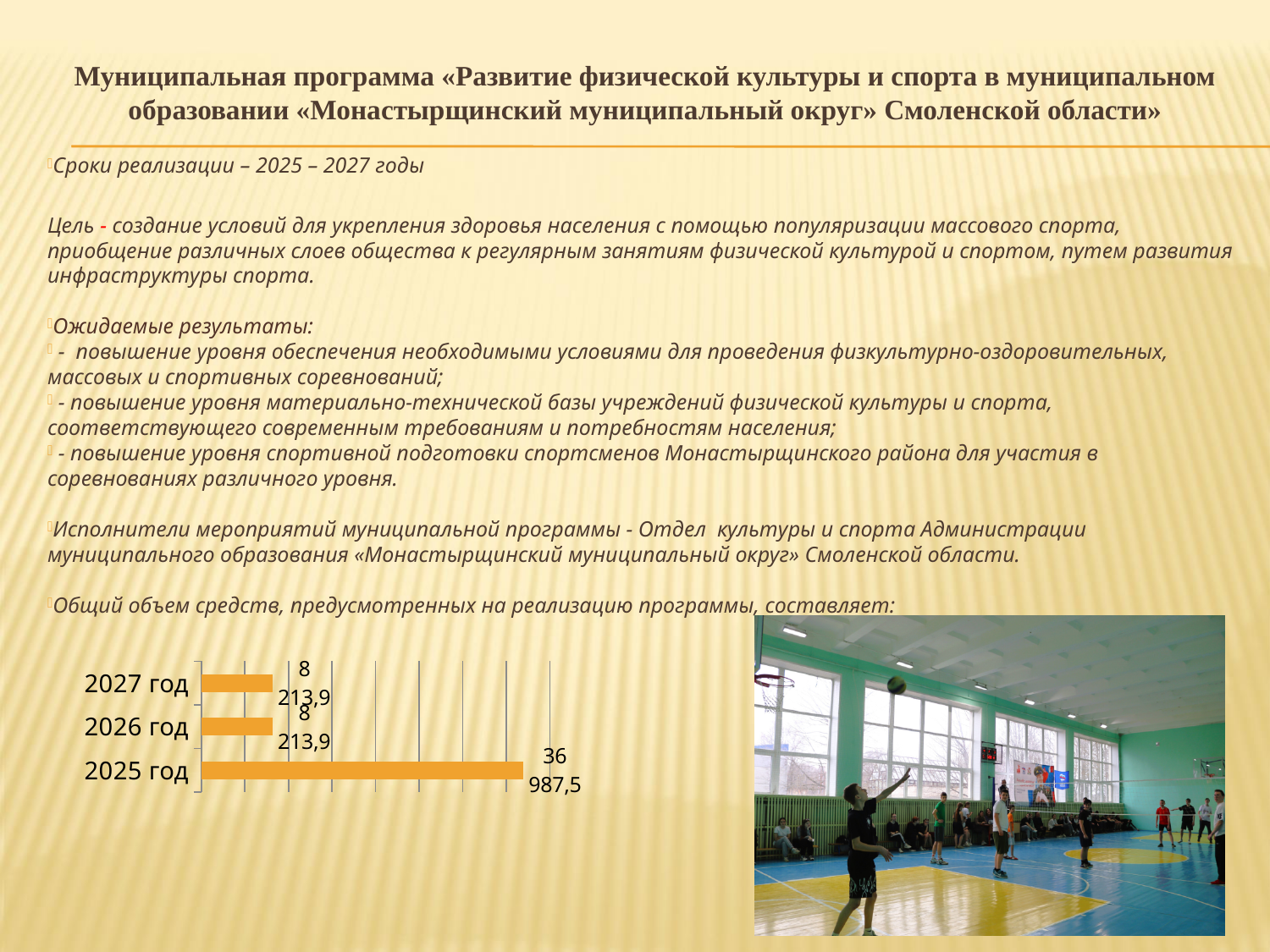
How many years (categories) are shown in the bar chart? 3 What kind of chart is shown on the slide? Bar chart Which is larger in the bar chart, the value for 2025 год or the value for 2027 год? 2025 год What is the value shown for 2027 год in the bar chart? 8 213,9 Do the values for 2026 год and 2027 год in the bar chart differ from each other? No, both are 8 213,9 What is the value shown for 2026 год in the bar chart? 8 213,9 What colour are the bars in the chart? Orange What is the value shown for 2025 год in the bar chart? 36 987,5 Are the bars in the chart drawn horizontally or vertically? Horizontally Which year has the highest value in the bar chart? 2025 год What is the difference between the values for 2025 год and 2026 год in the bar chart? 28 773,6